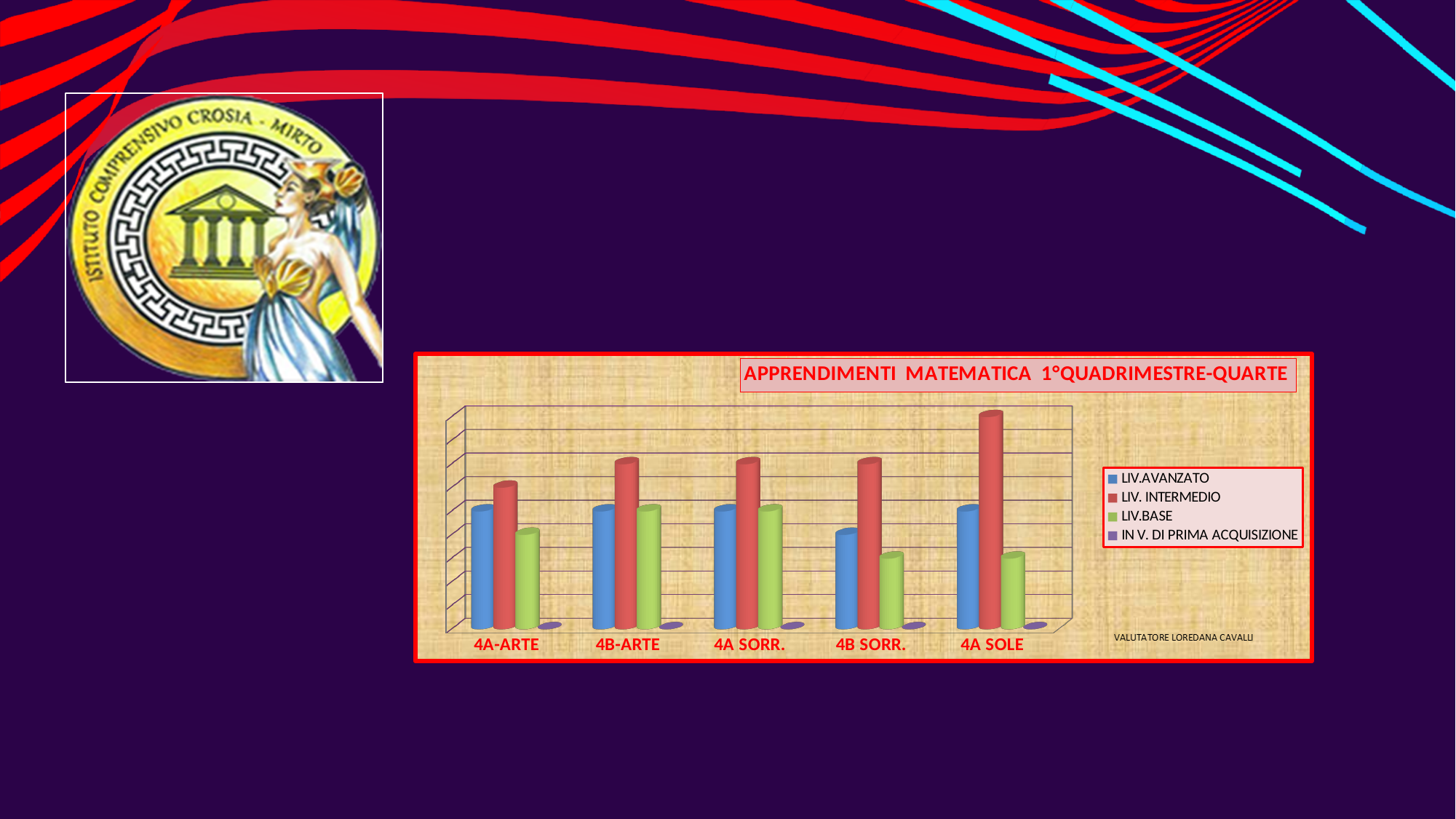
Which series is shown in red in the chart? LIV. INTERMEDIO How many series does the chart legend list? 4 What kind of chart is shown on the slide? Bar chart Which class has the lowest LIV. INTERMEDIO bar? 4A-ARTE For 4A SOLE, is the LIV. INTERMEDIO bar larger or the LIV.BASE bar? LIV. INTERMEDIO What is the title of the chart? APPRENDIMENTI MATEMATICA 1°QUADRIMESTRE-QUARTE How many categories (classes) are shown on the x axis of the chart? 5 Which class has the lowest LIV.AVANZATO bar? 4B SORR. Which class has the highest LIV. INTERMEDIO bar? 4A SOLE For 4A-ARTE, which is larger: the LIV.AVANZATO bar or the LIV.BASE bar? LIV.AVANZATO Which series has the smallest bars across all classes in the chart? IN V. DI PRIMA ACQUISIZIONE Is the LIV.BASE bar larger for 4A-ARTE or for 4B-ARTE? 4B-ARTE